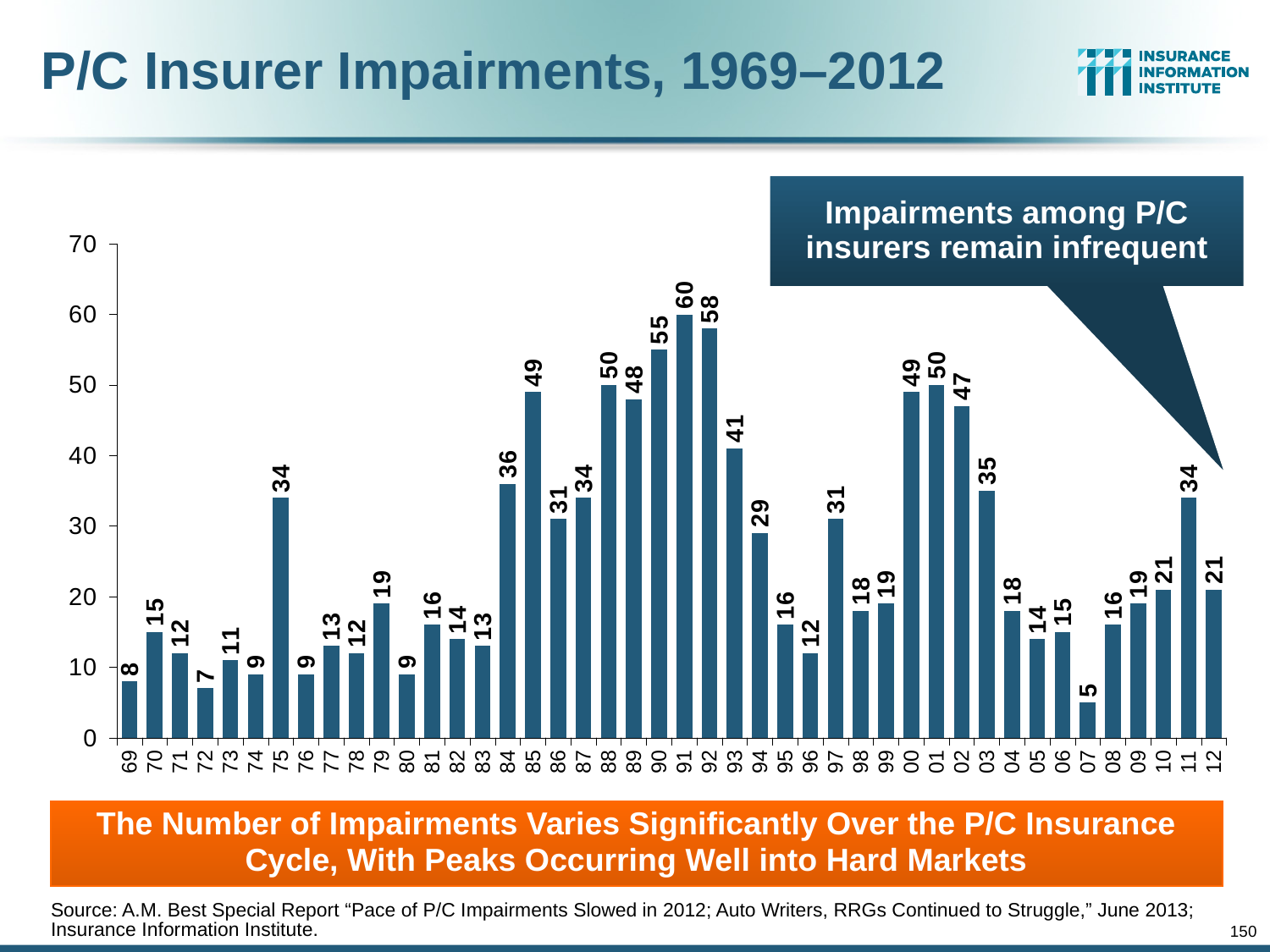
What is the difference between the number of impairments in 1991 and in 1992? 2 What is the number of P/C insurer impairments in 1991? 60 What does the callout box on the chart say? Impairments among P/C insurers remain infrequent Which year had more impairments, 1985 or 2002? 1985 What kind of chart is shown on the slide? Bar chart What is the number of impairments shown for 2012? 21 Which year has the lowest number of impairments? 2007 Which year has the highest number of impairments? 1991 What is the number of impairments shown for 2007? 5 How many years are plotted on the chart? 44 What is the difference between the number of impairments in 2011 and in 2012? 13 Is the value for 1990 greater or less than 50? greater